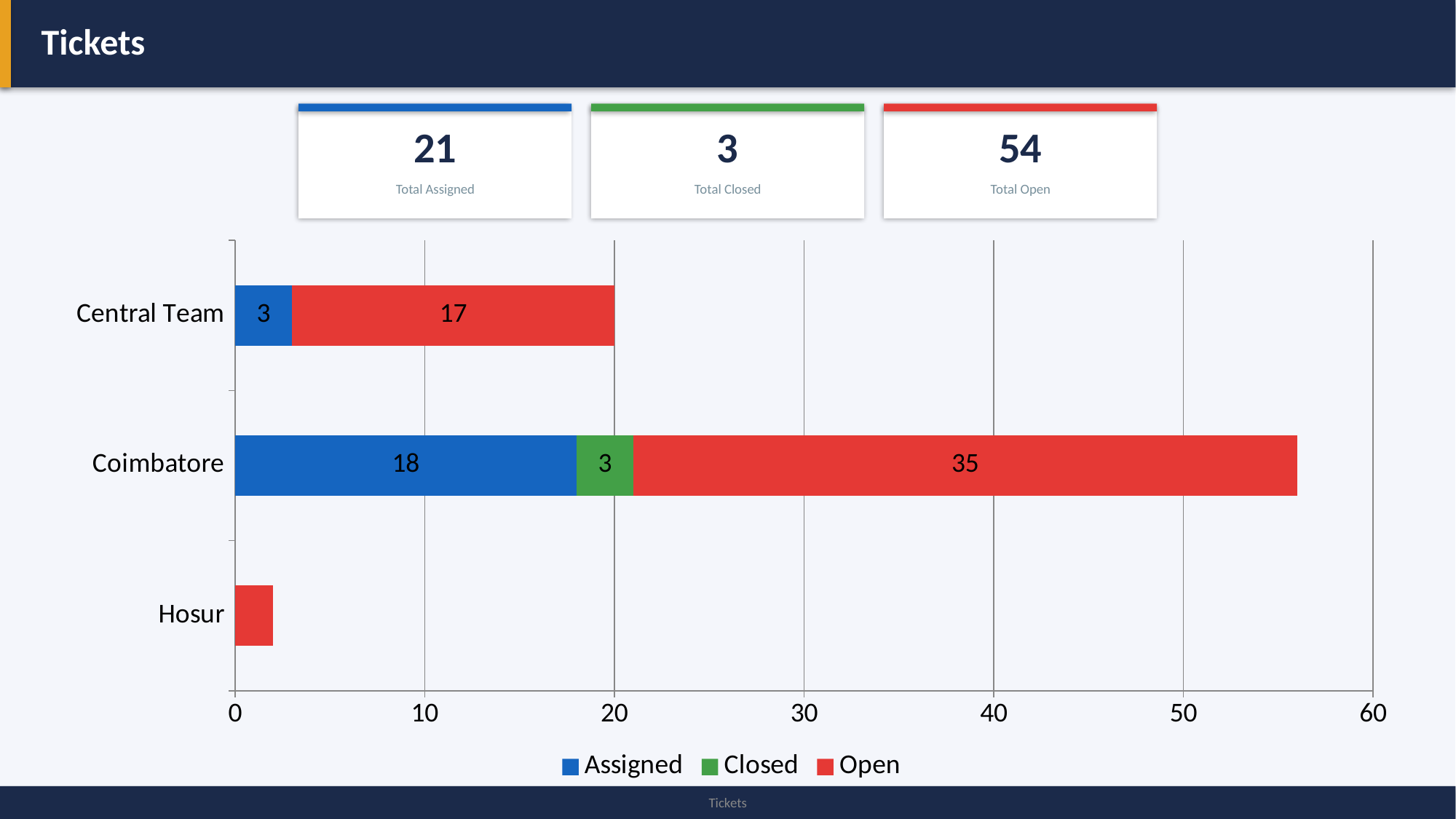
What is the Assigned value for Central Team? 3 What is the difference between the Open value for Coimbatore and the Open value for Central Team? 18 How many series does the legend list? 3 Which category has the shortest bar overall? Hosur What is the total of the stacked bar for Central Team? 20 What is the Open value for Central Team? 17 Which has the larger Assigned value, Coimbatore or Central Team? Coimbatore What kind of chart is shown on the slide? bar chart What is the Closed value for Coimbatore? 3 Is the value for Hosur greater or less than 10? less What is the total of the stacked bar for Coimbatore? 56 What is the Open value for Coimbatore? 35